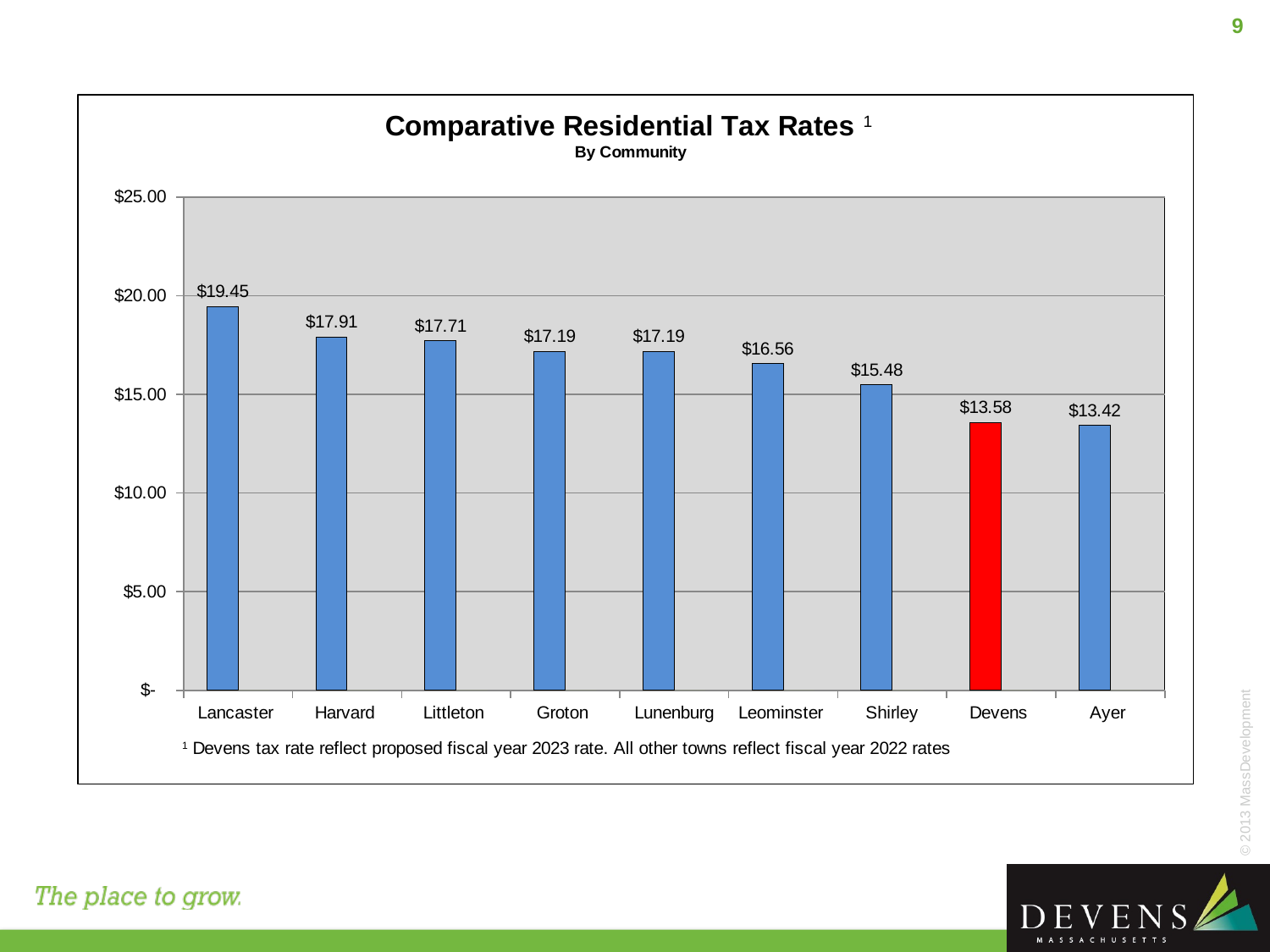
How many communities are shown in the chart? 9 Which community has the lowest residential tax rate? Ayer What is the difference between the tax rates of Harvard and Littleton? $0.20 Is the value for Groton greater or less than $15.00? greater Which has a higher residential tax rate, Leominster or Shirley? Leominster What is the residential tax rate for Lancaster? $19.45 What type of chart is shown on the slide? Bar chart What is the residential tax rate for Shirley? $15.48 What is the residential tax rate for Devens? $13.58 Which community has the highest residential tax rate? Lancaster What is the difference between the tax rates of Lancaster and Devens? $5.87 Which community's bar is coloured red? Devens